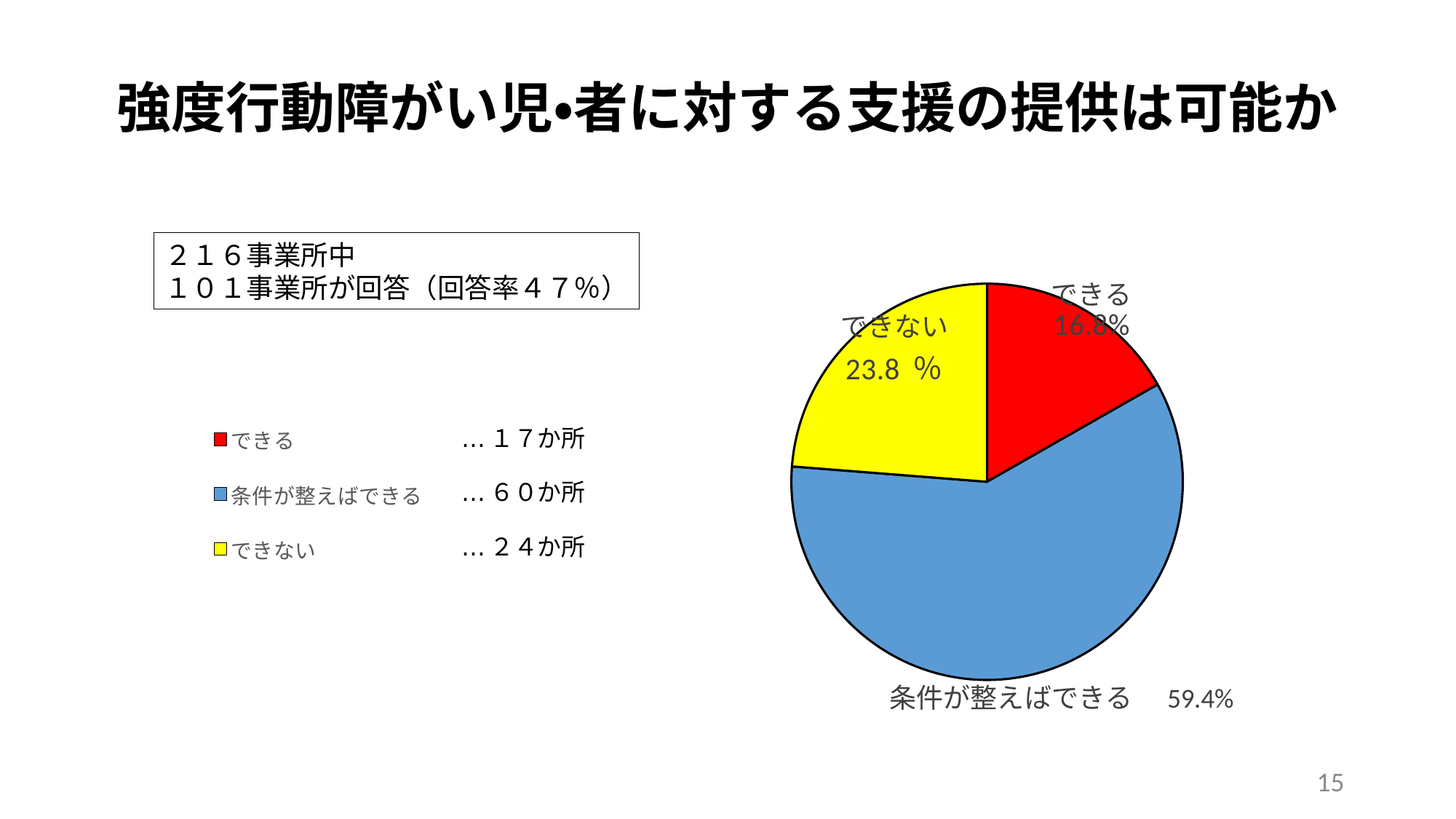
What percentage of the pie chart does the できる slice represent? 16.8% What percentage of the pie chart does the 条件が整えばできる slice represent? 59.4% According to the legend, how many locations (か所) answered できない? ２４か所 Which category has the smallest slice in the pie chart? できる According to the legend, how many locations (か所) answered できる? １７か所 Which slice is larger, できない or できる? できない What type of chart is shown on the slide? Pie chart What percentage of the pie chart does the できない slice represent? 23.8 % How many categories are shown in the pie chart? 3 According to the legend, how many locations (か所) answered 条件が整えばできる? ６０か所 Which category has the largest slice in the pie chart? 条件が整えばできる What is the difference in percentage points between the 条件が整えばできる slice and the できる slice? 42.6